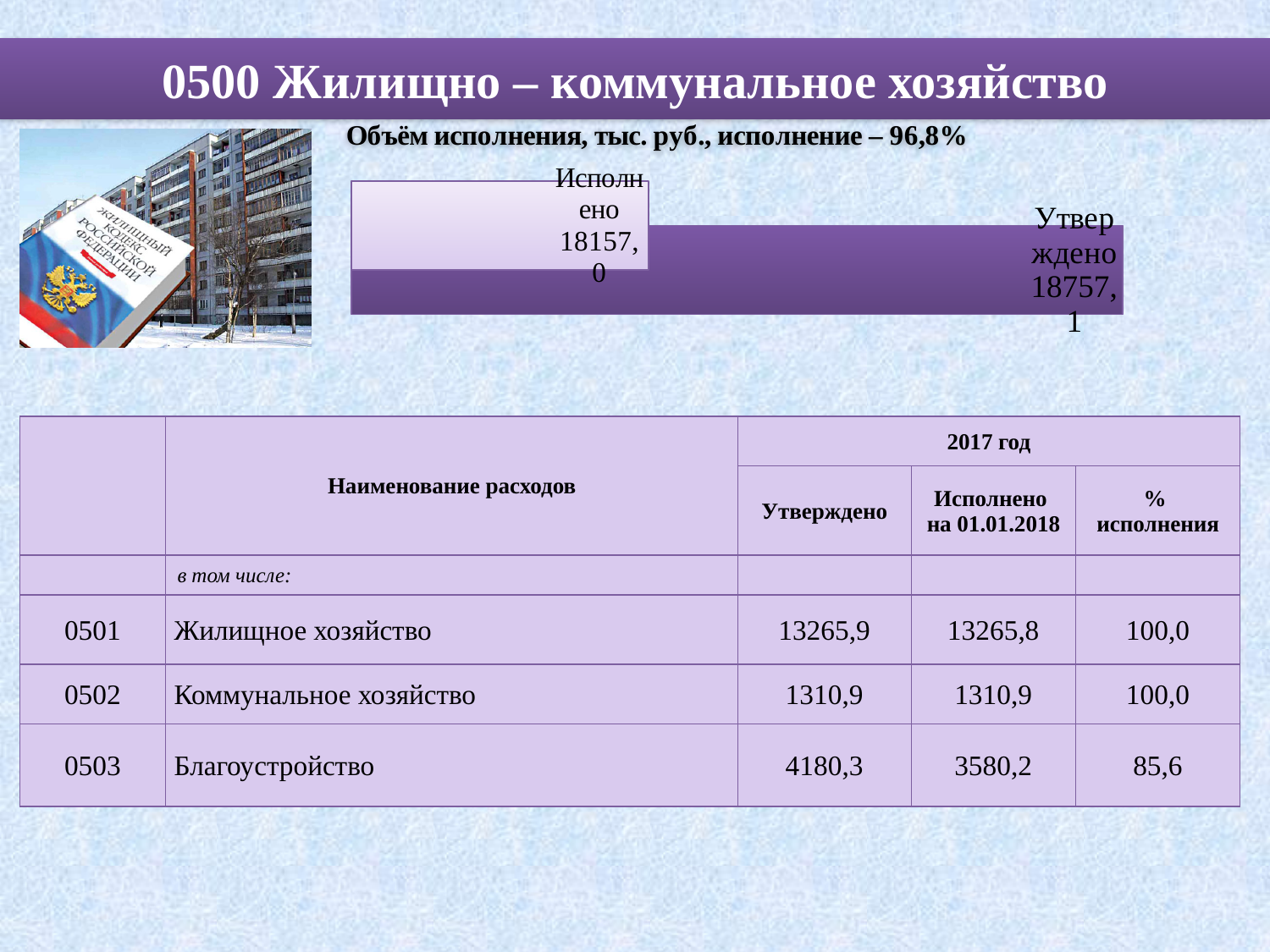
Is the "Исполнено" value larger or smaller than the "Утверждено" value in the chart? smaller What is the value of the "Утверждено" bar in the chart? 18757,1 What type of chart is shown on the slide? bar chart What is the title of the chart on the slide? Объём исполнения, тыс. руб., исполнение – 96,8% Which bar in the chart has the lower value? Исполнено Which bar in the chart has the higher value? Утверждено What execution percentage is stated in the chart title? 96,8% What is the difference between the "Утверждено" and "Исполнено" values in the chart? 600,1 What is the value of the "Исполнено" bar in the chart? 18157,0 How many bars are plotted in the chart? 2